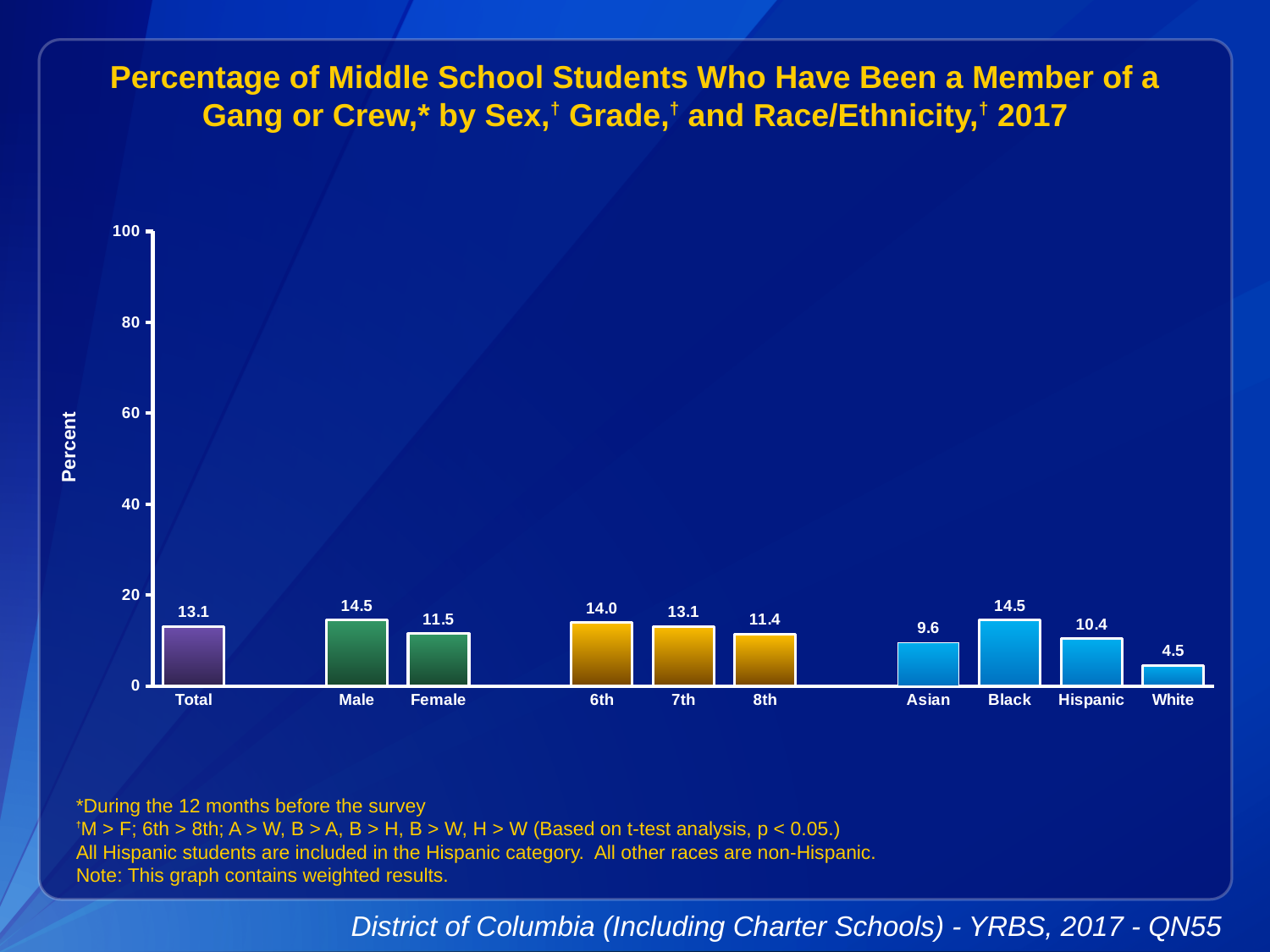
What is the value for Total? 13.1 What is the difference between the values for Male and Female? 3.0 Which is larger, the value for Hispanic or the value for Asian? Hispanic Which grade has the highest value? 6th How many categories are shown on the x axis? 10 Is the value for 8th greater or less than 20? less What is the value for Female? 11.5 Which category has the lowest value? White What is the label of the y axis? Percent What kind of chart is this? bar chart What is the difference between the values for Black and Asian? 4.9 What is the value for White? 4.5